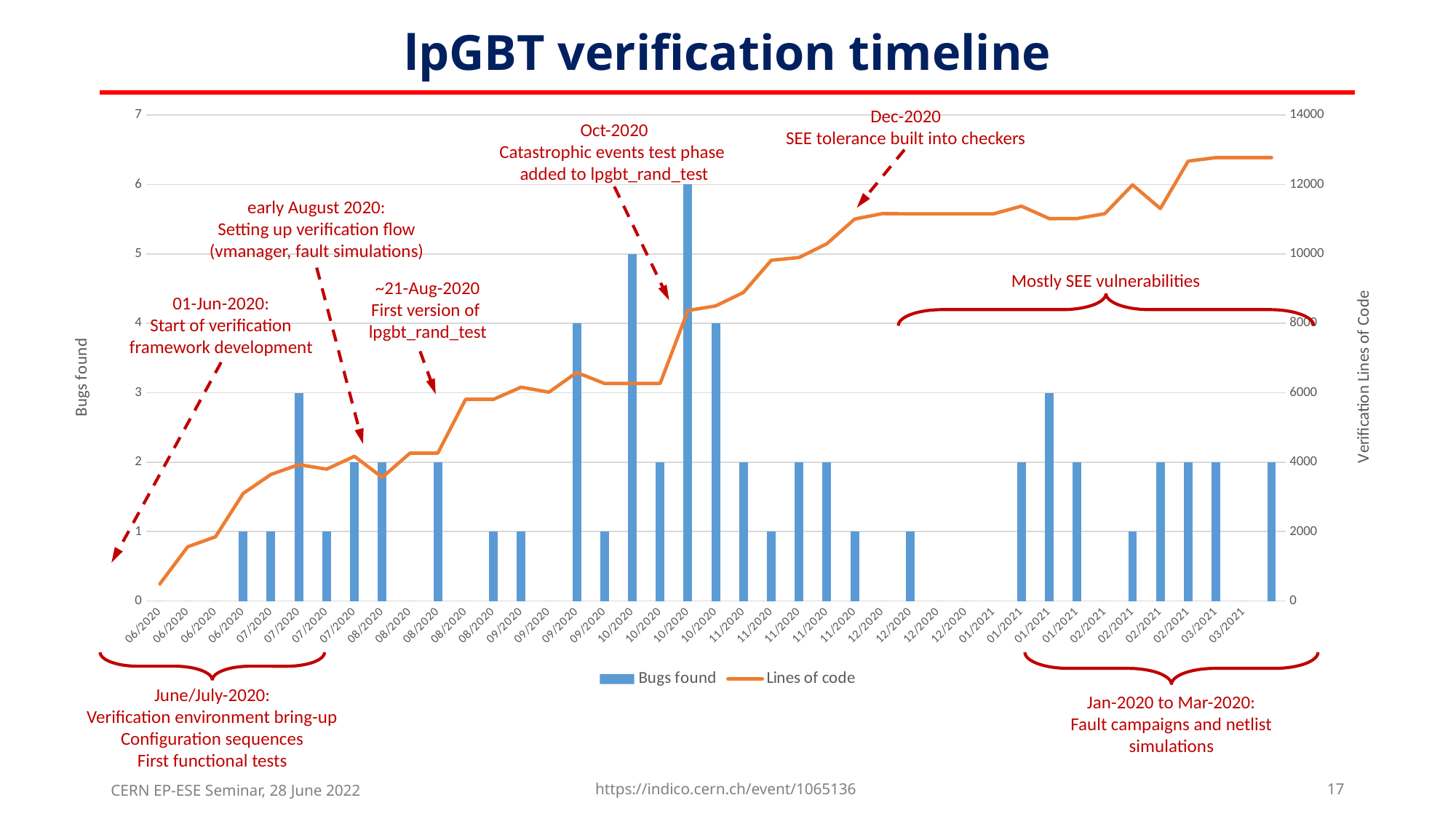
Is the 'Lines of code' value at the first point (06/2020) greater or less than 2000? less What is the title of the right-hand vertical axis? Verification Lines of Code Is the 'Lines of code' value at the last point (03/2021) greater or less than 12000? greater What kind of chart is shown on the slide? A combined bar and line chart How many series does the chart legend list? 2 Does the 'Lines of code' series generally rise or fall from 06/2020 to 03/2021? rise How many periods on the chart have exactly 4 bugs found? 2 Is the 'Lines of code' value in 12/2020 greater or less than 10000? greater What are the two series named in the chart legend? Bugs found and Lines of code In which month does the tallest 'Bugs found' bar occur? 10/2020 What is the highest number of bugs found in any single period on the chart? 6 What is the highest number of bugs found in any single period during 2021? 3